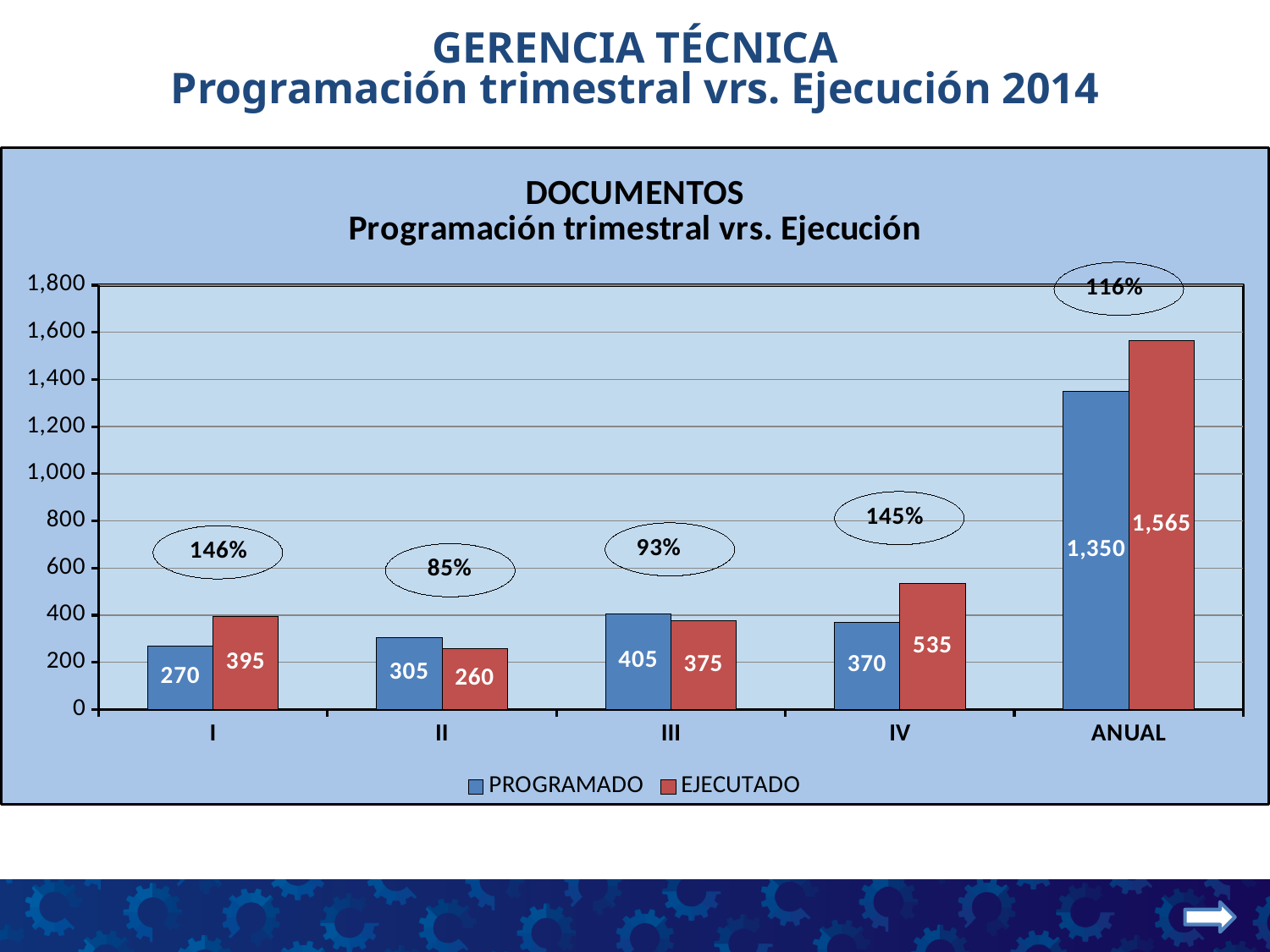
What is the PROGRAMADO value for quarter I? 270 What is the EJECUTADO value for quarter IV? 535 How many series does the legend list? 2 Is the EJECUTADO value for ANUAL greater or less than 1,400? greater What is the difference between EJECUTADO and PROGRAMADO for quarter IV? 165 Which is larger for quarter II, PROGRAMADO or EJECUTADO? PROGRAMADO What kind of chart is shown? bar chart Which quarter (I–IV) has the lowest PROGRAMADO value? I What is the EJECUTADO value for ANUAL? 1,565 What percentage is shown in the circle above quarter III? 93% Which quarter (I–IV) has the highest EJECUTADO value? IV How many categories are shown on the x axis? 5